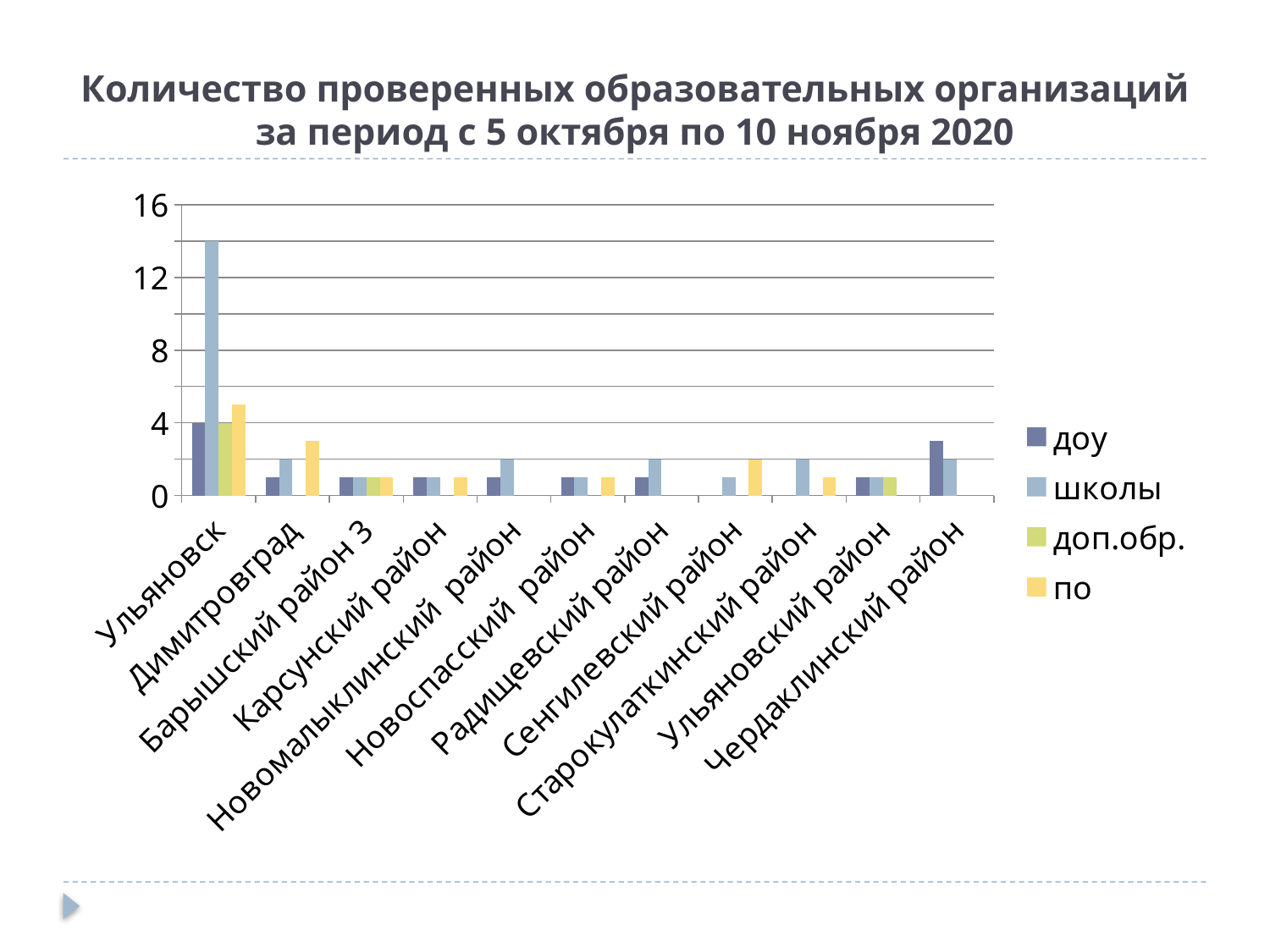
What kind of chart is shown on the slide? bar chart How many series does the legend list? 4 Is the value for по in Ульяновск greater or less than 4? greater Is the value for школы in Ульяновск greater or less than 12? greater Which category has the highest value for the школы series? Ульяновск In Димитровград, which is larger: the value for по or the value for школы? по How many categories (districts/cities) are shown on the x axis? 11 Is the value for по in Димитровград greater or less than 4? less What is the value for доу in Ульяновск? 4 In Ульяновск, which is larger: the value for школы or the value for по? школы What are the four legend entries of the chart? доу, школы, доп.обр., по